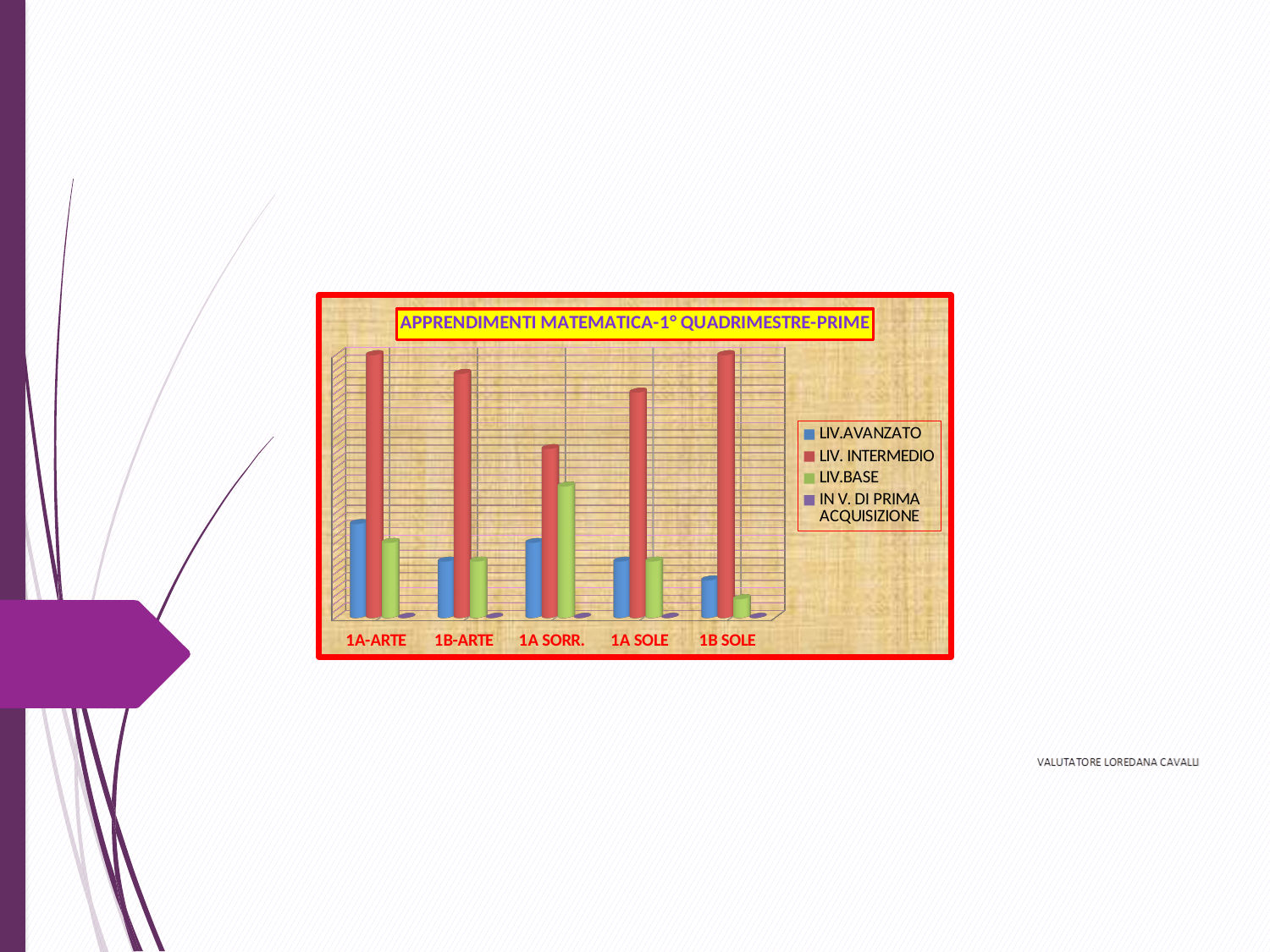
How many classes (categories) are shown on the x axis? 5 Which class has the larger LIV. INTERMEDIO bar: 1B-ARTE or 1A SOLE? 1B-ARTE Which class has the highest LIV.AVANZATO bar? 1A-ARTE What is the title of the chart? APPRENDIMENTI MATEMATICA-1° QUADRIMESTRE-PRIME Which class has the lowest LIV. INTERMEDIO bar? 1A SORR. Which class has the lowest LIV.BASE bar? 1B SOLE Which class has the highest LIV.BASE bar? 1A SORR. How many series does the legend list? 4 Which class has the lowest LIV.AVANZATO bar? 1B SOLE Which series is shown in red in the legend? LIV. INTERMEDIO What kind of chart is shown on the slide? bar chart For 1A SORR., which is larger: LIV.AVANZATO or LIV.BASE? LIV.BASE